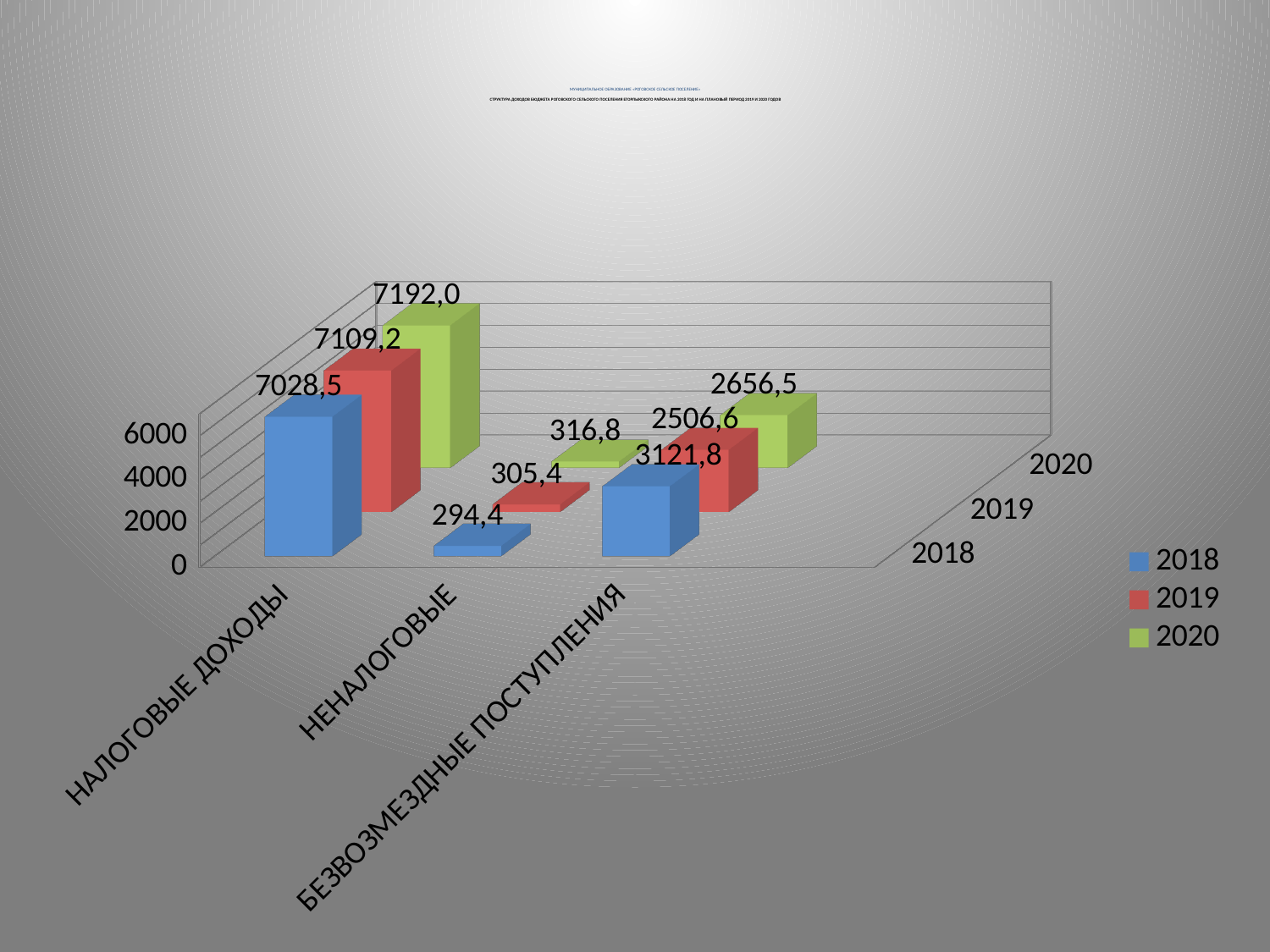
Which category has the lowest value in 2018? НЕНАЛОГОВЫЕ Which is larger for БЕЗВОЗМЕЗДНЫЕ ПОСТУПЛЕНИЯ: the 2018 value or the 2020 value? 2018 What is the value for НАЛОГОВЫЕ ДОХОДЫ in 2020? 7192,0 How many series does the legend list? 3 What is the value for НЕНАЛОГОВЫЕ in 2020? 316,8 What is the difference between the 2020 and 2018 values for НАЛОГОВЫЕ ДОХОДЫ? 163,5 What is the value for НАЛОГОВЫЕ ДОХОДЫ in 2018? 7028,5 What kind of chart is shown on the slide? Bar chart What is the value for БЕЗВОЗМЕЗДНЫЕ ПОСТУПЛЕНИЯ in 2019? 2506,6 Which category has the highest value in 2019? НАЛОГОВЫЕ ДОХОДЫ How many categories are shown on the x axis? 3 What is the difference between the 2018 and 2019 values for БЕЗВОЗМЕЗДНЫЕ ПОСТУПЛЕНИЯ? 615,2